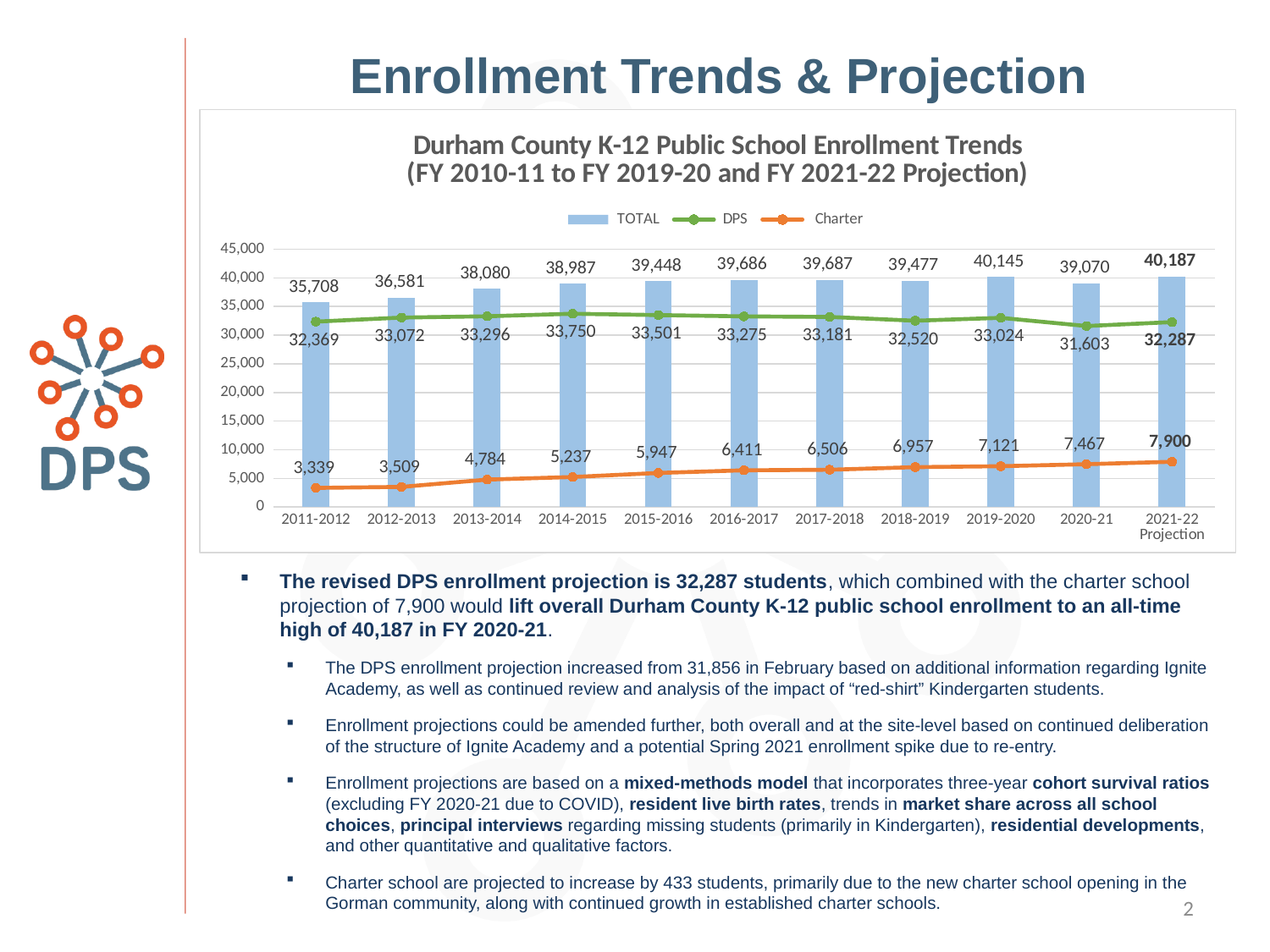
How many years (categories) are shown on the x axis of the chart? 11 What is the TOTAL enrollment value for 2019-2020? 40,145 Which is larger, the TOTAL value for 2019-2020 or the TOTAL value for the 2021-22 Projection? 2021-22 Projection In which year is the Charter enrollment lowest? 2011-2012 In which year is the DPS enrollment highest? 2014-2015 What is the difference between the Charter value for the 2021-22 Projection and the Charter value for 2020-21? 433 What is the Charter enrollment value for the 2021-22 Projection? 7,900 In which year is the DPS enrollment lowest? 2020-21 How many series does the chart legend list? 3 Does the Charter enrollment rise or fall from 2011-2012 to the 2021-22 Projection? Rise What is the difference between the TOTAL value for the 2021-22 Projection and the TOTAL value for 2011-2012? 4,479 What is the DPS enrollment value for 2014-2015? 33,750